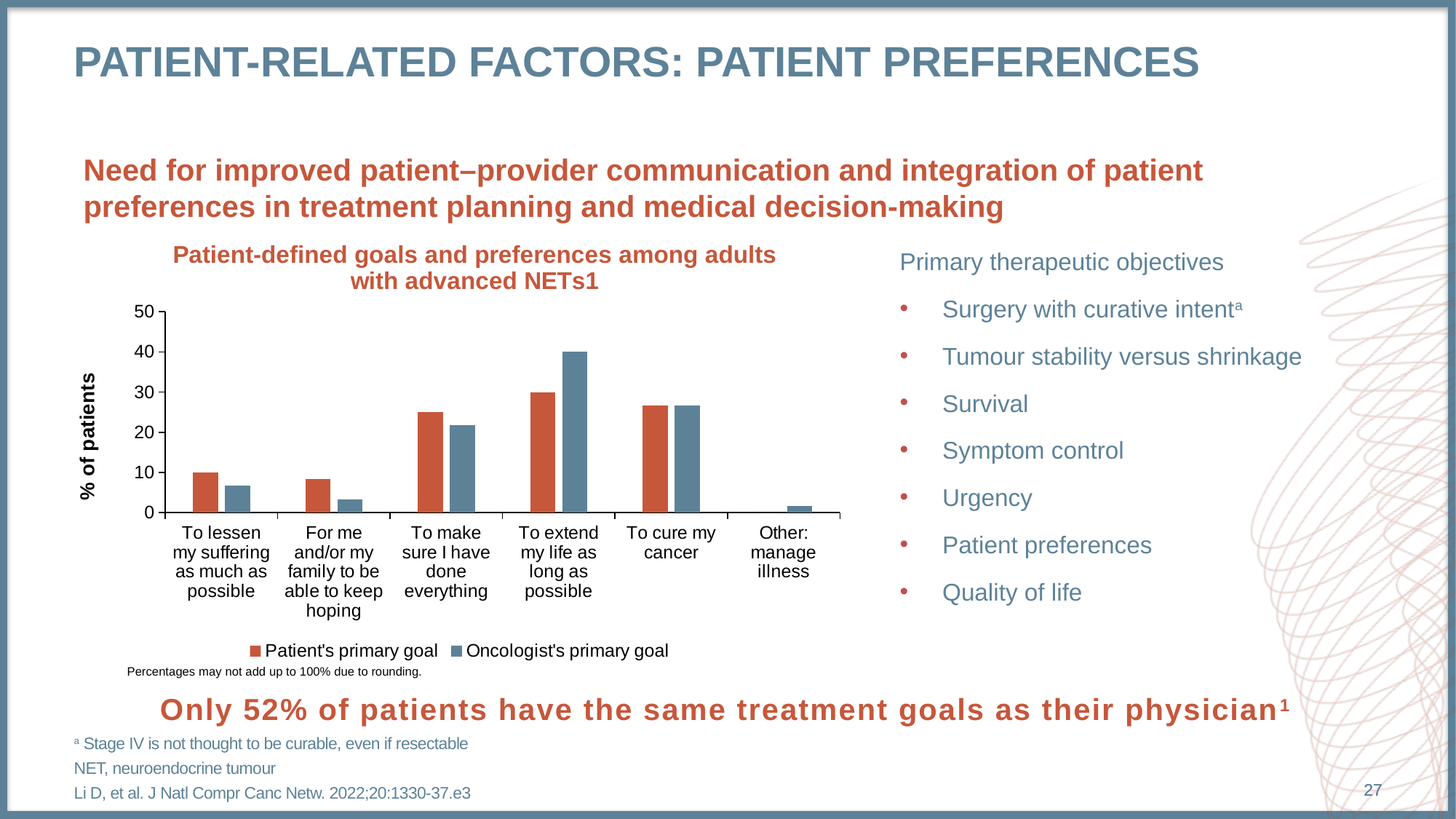
How many series does the chart legend list? 2 Which category has the lowest value for Patient's primary goal? Other: manage illness Which category has the lowest value for Oncologist's primary goal? Other: manage illness Which category has the highest value for Patient's primary goal? To extend my life as long as possible What is the value for Oncologist's primary goal in the category 'To extend my life as long as possible'? 40 For 'To extend my life as long as possible', which is larger: Patient's primary goal or Oncologist's primary goal? Oncologist's primary goal How many goal categories are shown on the x axis of the chart? 6 Is the value for Patient's primary goal in 'For me and/or my family to be able to keep hoping' greater or less than 10? less What is the label on the y axis of the chart? % of patients Which category has the highest value for Oncologist's primary goal? To extend my life as long as possible What kind of chart is shown on the slide? Bar chart For 'To lessen my suffering as much as possible', which is larger: Patient's primary goal or Oncologist's primary goal? Patient's primary goal